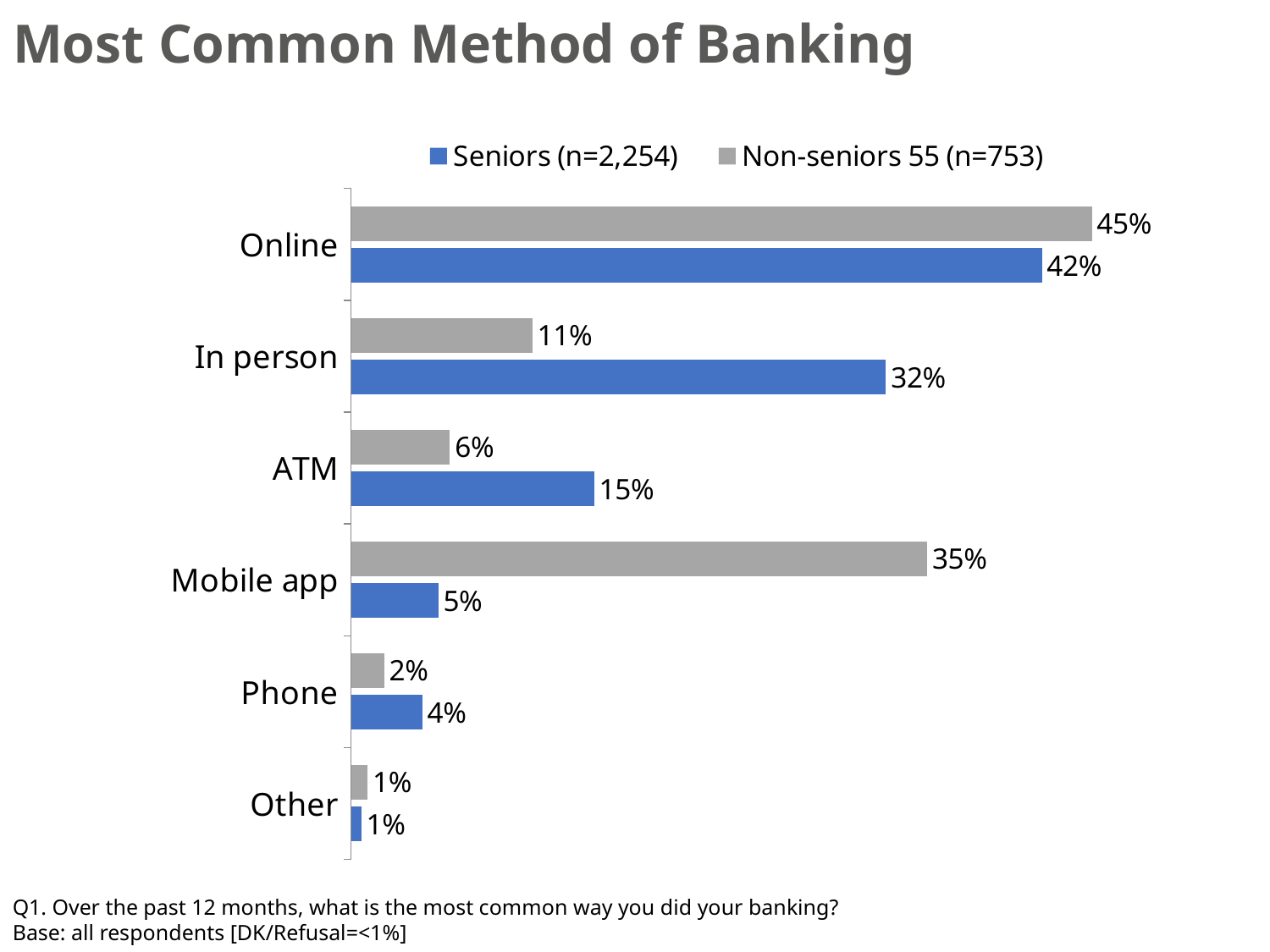
What is the difference between Seniors and Non-seniors 55 for In person banking? 21 percentage points Which banking method has the lowest value for Non-seniors 55 (n=753)? Other For Mobile app, which group has the larger value: Seniors (n=2,254) or Non-seniors 55 (n=753)? Non-seniors 55 (n=753) How many series does the legend list? 2 For ATM, which group has the larger value: Seniors (n=2,254) or Non-seniors 55 (n=753)? Seniors (n=2,254) What colour represents Seniors (n=2,254) in the chart? Blue What percentage of Seniors (n=2,254) reported Online as their most common method of banking? 42% What type of chart is shown on the slide? Bar chart What is the value for In person among Non-seniors 55 (n=753)? 11% Which banking method has the highest value for Seniors (n=2,254)? Online What percentage of Non-seniors 55 (n=753) reported Mobile app as their most common method of banking? 35% How many banking method categories are shown on the chart? 6